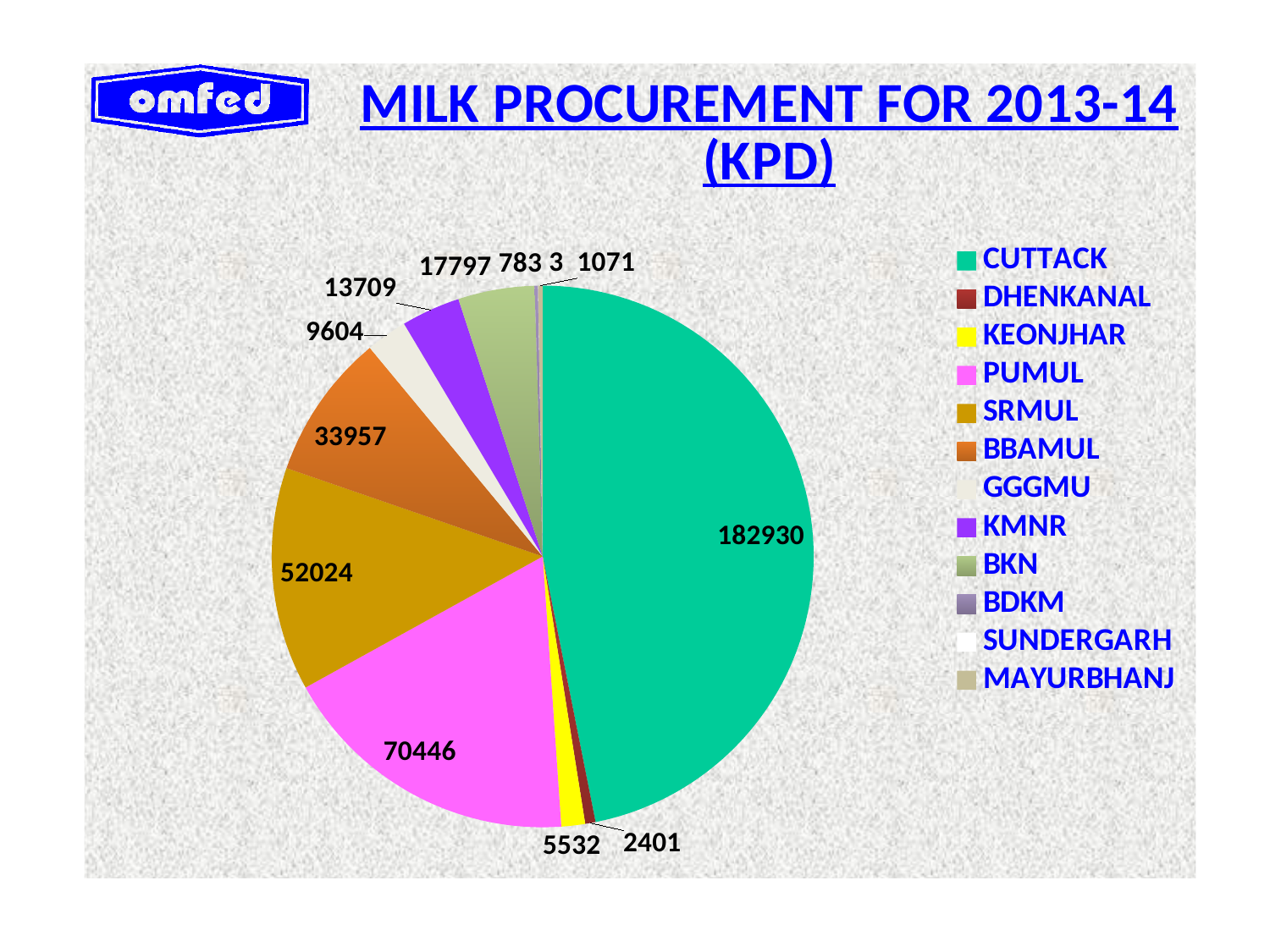
What kind of chart is shown? Pie chart What is the value for BBAMUL? 33957 What colour is the slice for PUMUL? Pink What is the value for KMNR? 13709 Which is larger, the value for SRMUL or the value for BBAMUL? SRMUL What is the value for PUMUL? 70446 Which category has the largest slice? CUTTACK Which category has the smallest slice? SUNDERGARH How many categories does the legend list? 12 What is the difference between the values for PUMUL and SRMUL? 18422 What is the title of the chart? MILK PROCUREMENT FOR 2013-14 (KPD) What is the value for CUTTACK? 182930